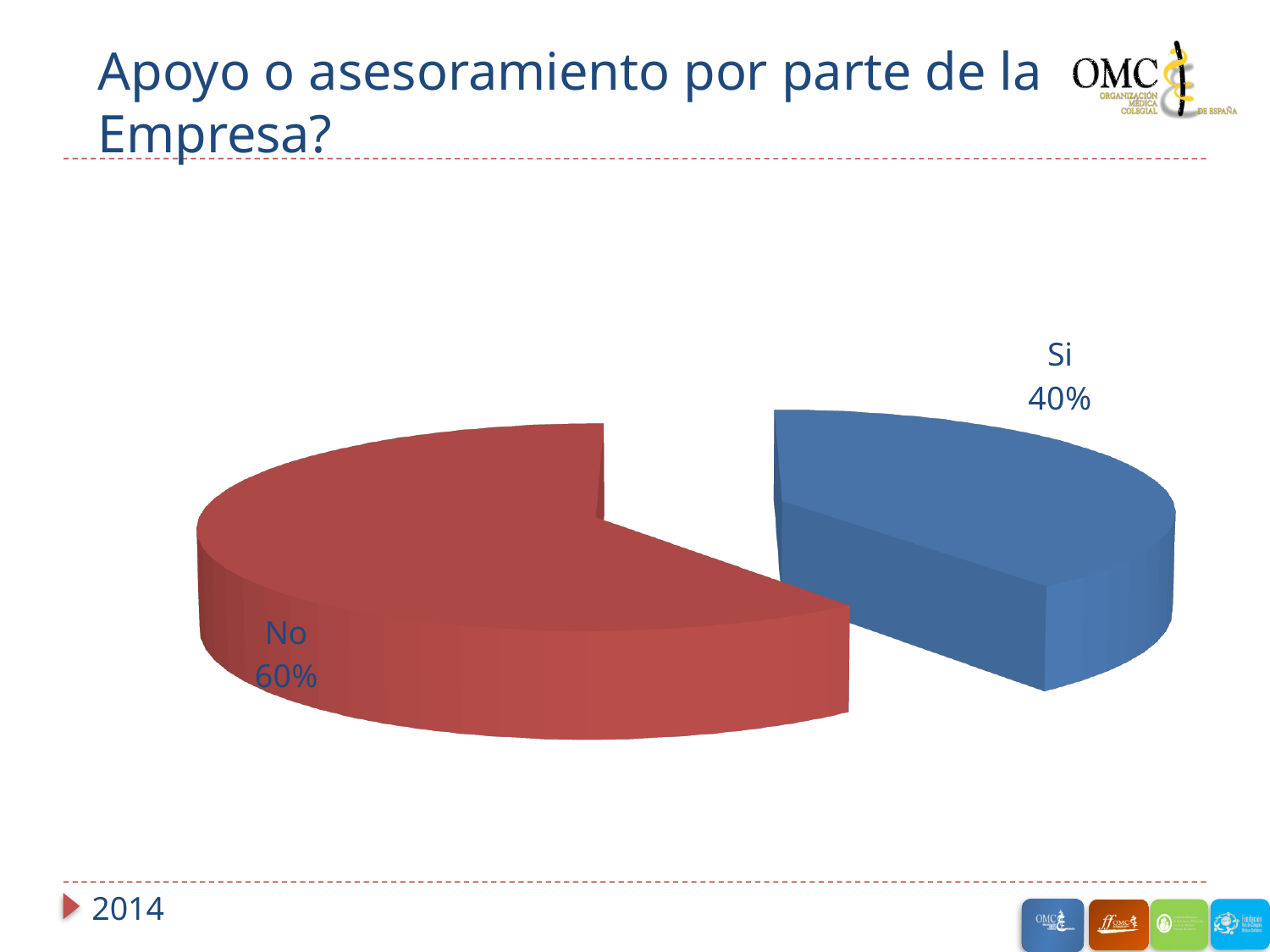
Which is larger, the "Si" slice or the "No" slice? No What colour is the "No" slice of the pie chart? Red What percentage of the pie chart is labelled "No"? 60% What percentage of the pie chart is labelled "Si"? 40% What share of the pie does the "Si" slice represent? 40% What kind of chart is shown on the slide? Pie chart What colour is the "Si" slice of the pie chart? Blue How many slices does the pie chart have? 2 Which slice of the pie chart is the smallest? Si Which slice of the pie chart is the largest? No What is the difference in percentage points between the "No" slice and the "Si" slice? 20